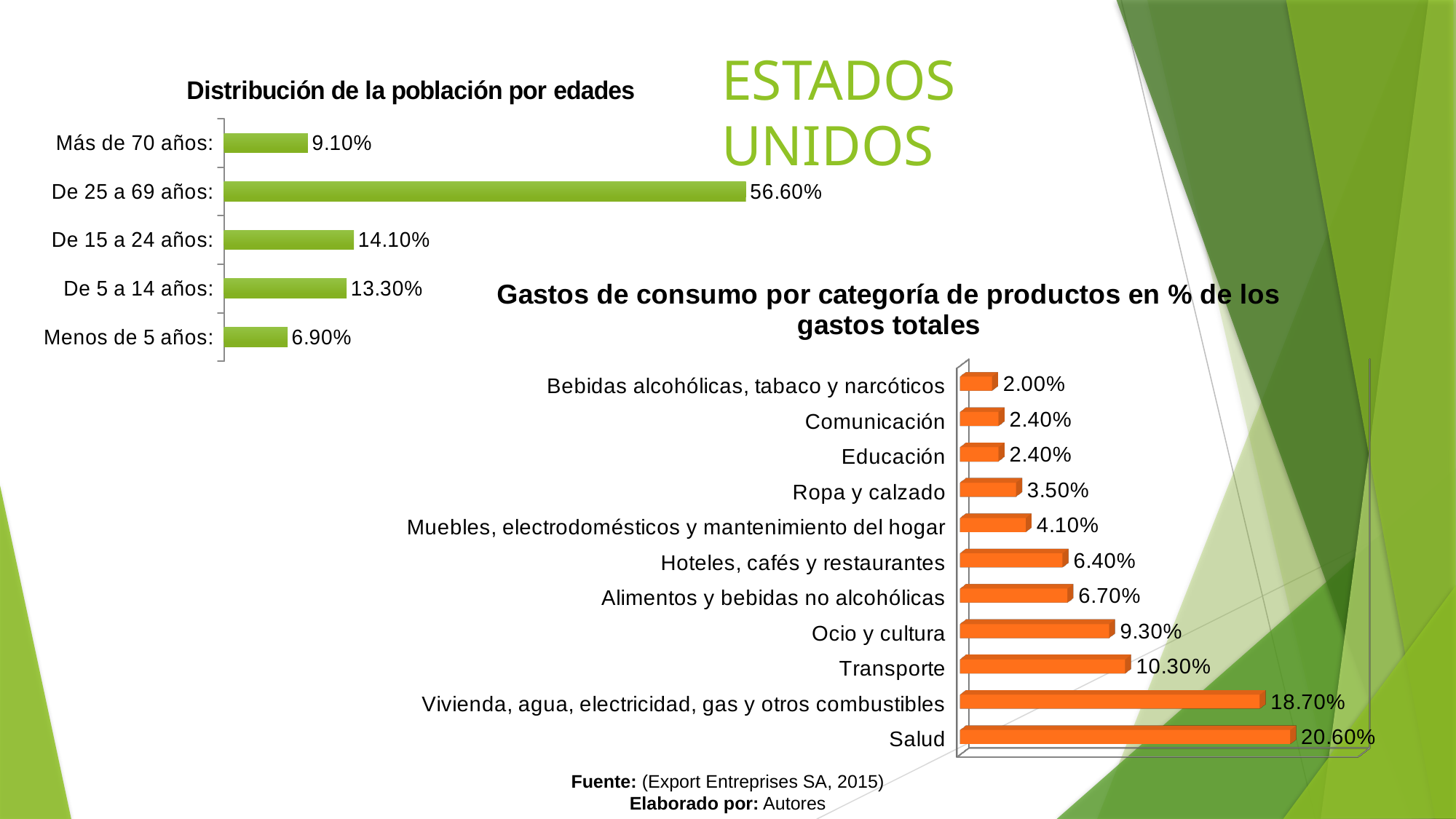
In the 'Gastos de consumo por categoría de productos' chart, which category has the highest value? Salud In the 'Distribución de la población por edades' chart, which age group has the lowest value? Menos de 5 años In the 'Gastos de consumo por categoría de productos' chart, which category has the lowest value? Bebidas alcohólicas, tabaco y narcóticos In the 'Distribución de la población por edades' chart, what is the value for 'De 25 a 69 años'? 56.60% In the 'Distribución de la población por edades' chart, which is larger: 'Más de 70 años' or 'Menos de 5 años'? Más de 70 años In the 'Gastos de consumo por categoría de productos' chart, what is the value for 'Transporte'? 10.30% What type of chart is the 'Gastos de consumo por categoría de productos' chart? Bar chart In the 'Gastos de consumo por categoría de productos' chart, how many categories are shown? 11 In the 'Distribución de la población por edades' chart, what is the difference between 'De 15 a 24 años' and 'De 5 a 14 años'? 0.80% What colour are the bars in the 'Distribución de la población por edades' chart? Green In the 'Distribución de la población por edades' chart, how many age categories are shown? 5 In the 'Gastos de consumo por categoría de productos' chart, what is the difference between 'Salud' and 'Vivienda, agua, electricidad, gas y otros combustibles'? 1.90%